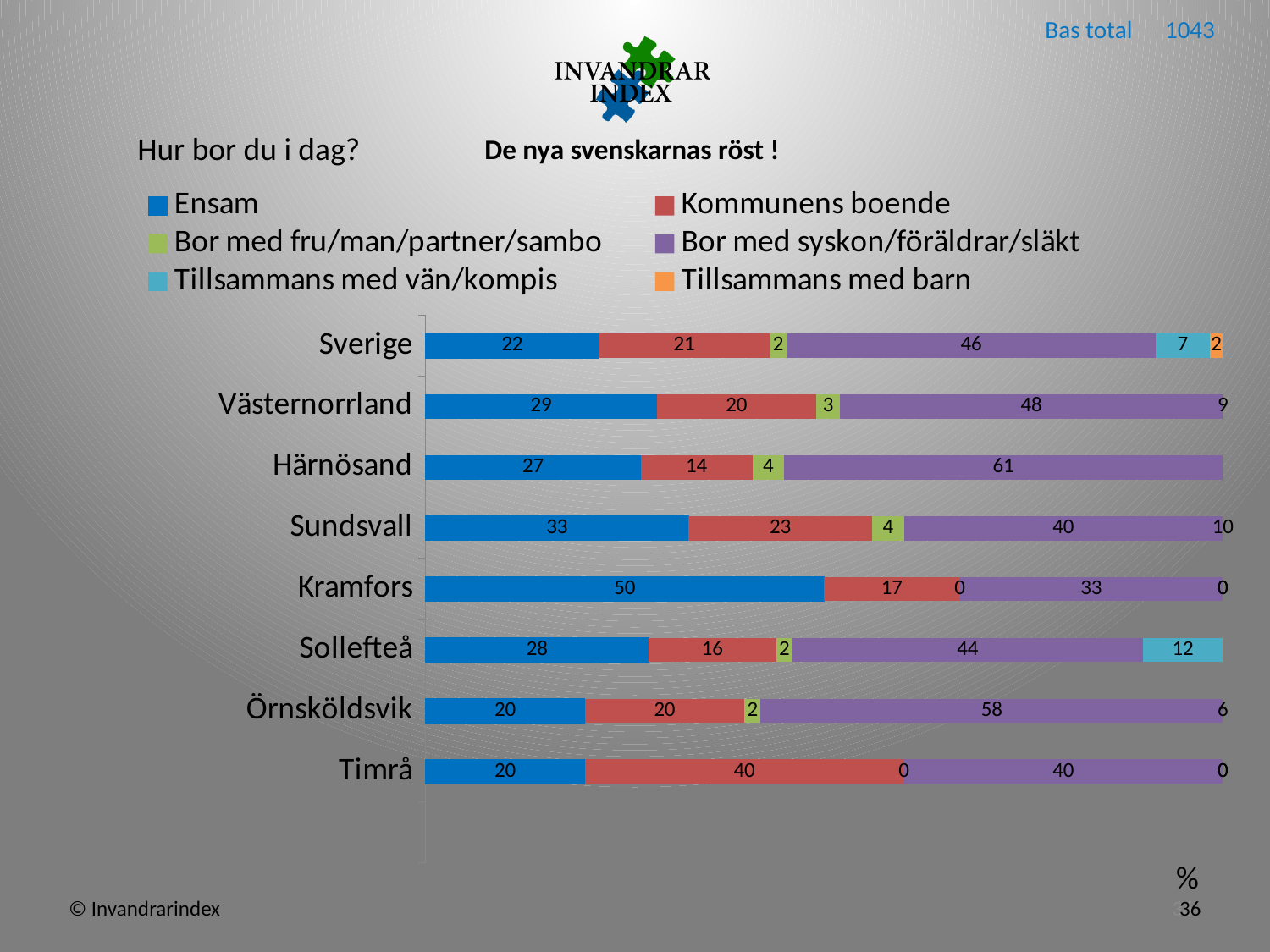
What kind of chart is shown on the slide? bar chart What is the value of Kommunens boende for Timrå? 40 Which category has the highest value for Bor med syskon/föräldrar/släkt? Härnösand How many categories (regions) are shown on the chart? 8 What is the value of Ensam for Kramfors? 50 Which has the larger Kommunens boende value, Timrå or Sverige? Timrå What is the question shown as the chart's title? Hur bor du i dag? How many series does the legend list? 6 What is the difference between the Ensam value for Sundsvall and the Ensam value for Sverige? 11 What is the value of Bor med syskon/föräldrar/släkt for Härnösand? 61 What is the value of Tillsammans med vän/kompis for Sollefteå? 12 Which category has the highest value for Ensam? Kramfors